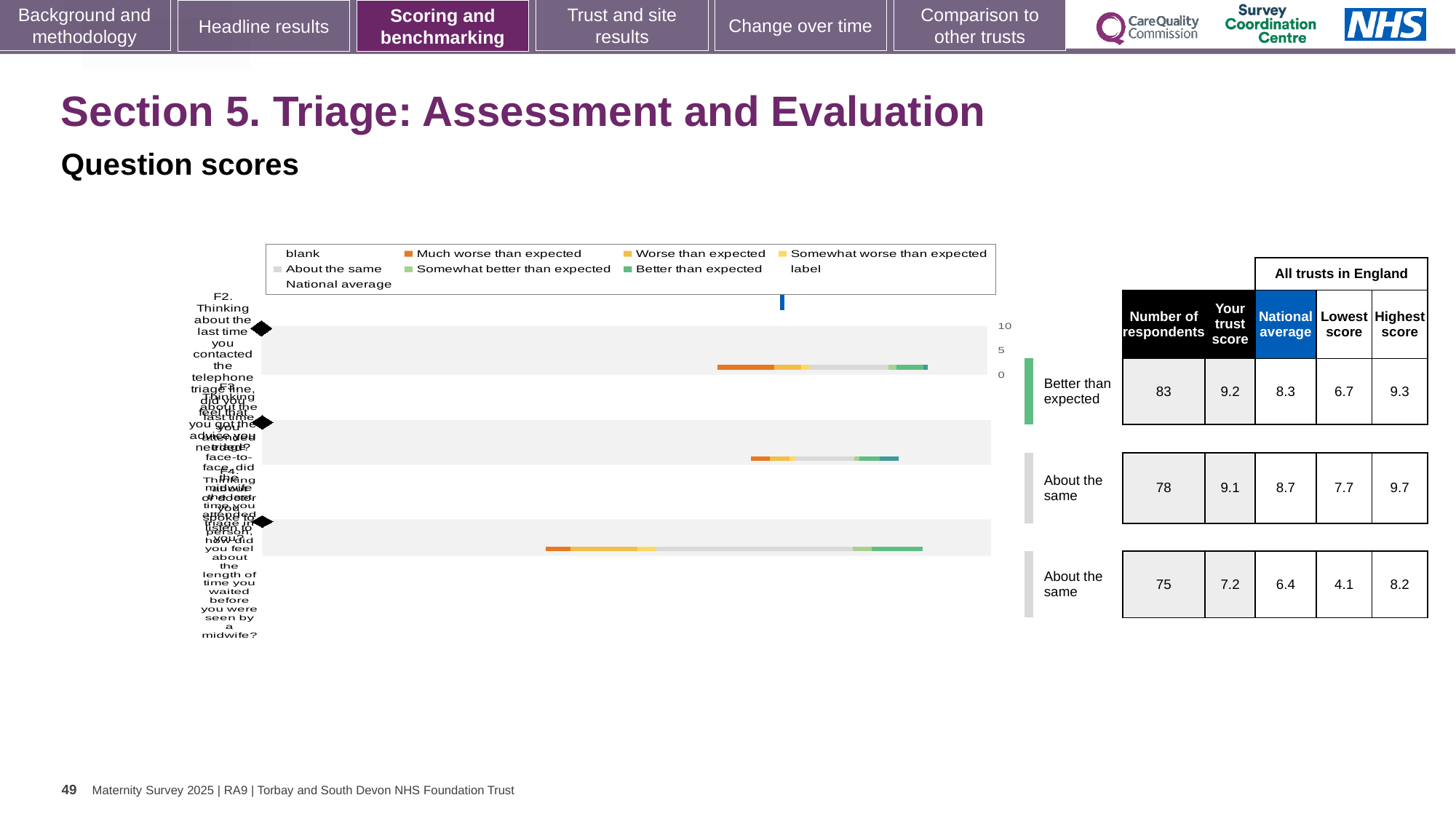
In the table beside the chart, what is the smallest value in the 'Lowest score' column? 4.1 In the table beside the chart, which question row has the highest number of respondents? the first row (F2), with 83 In the table beside the chart, what is the trust score for the first question (F2)? 9.2 What kind of chart is shown on the slide? bar chart In the chart legend, what colour represents 'Much worse than expected'? orange In the table beside the chart, what is the highest score for the third (bottom) question row? 8.2 How many question bars are plotted in the chart? 3 In the chart legend, what colour represents 'Better than expected'? green In the table beside the chart, what is the difference between the trust score and the national average for the first question (F2)? 0.9 In the table beside the chart, what is the national average for the first question (F2)? 8.3 In the table beside the chart, which is larger for the first question (F2): the trust score or the national average? the trust score (9.2) In the table beside the chart, what is the number of respondents for the first question (F2, about contacting the telephone triage line)? 83